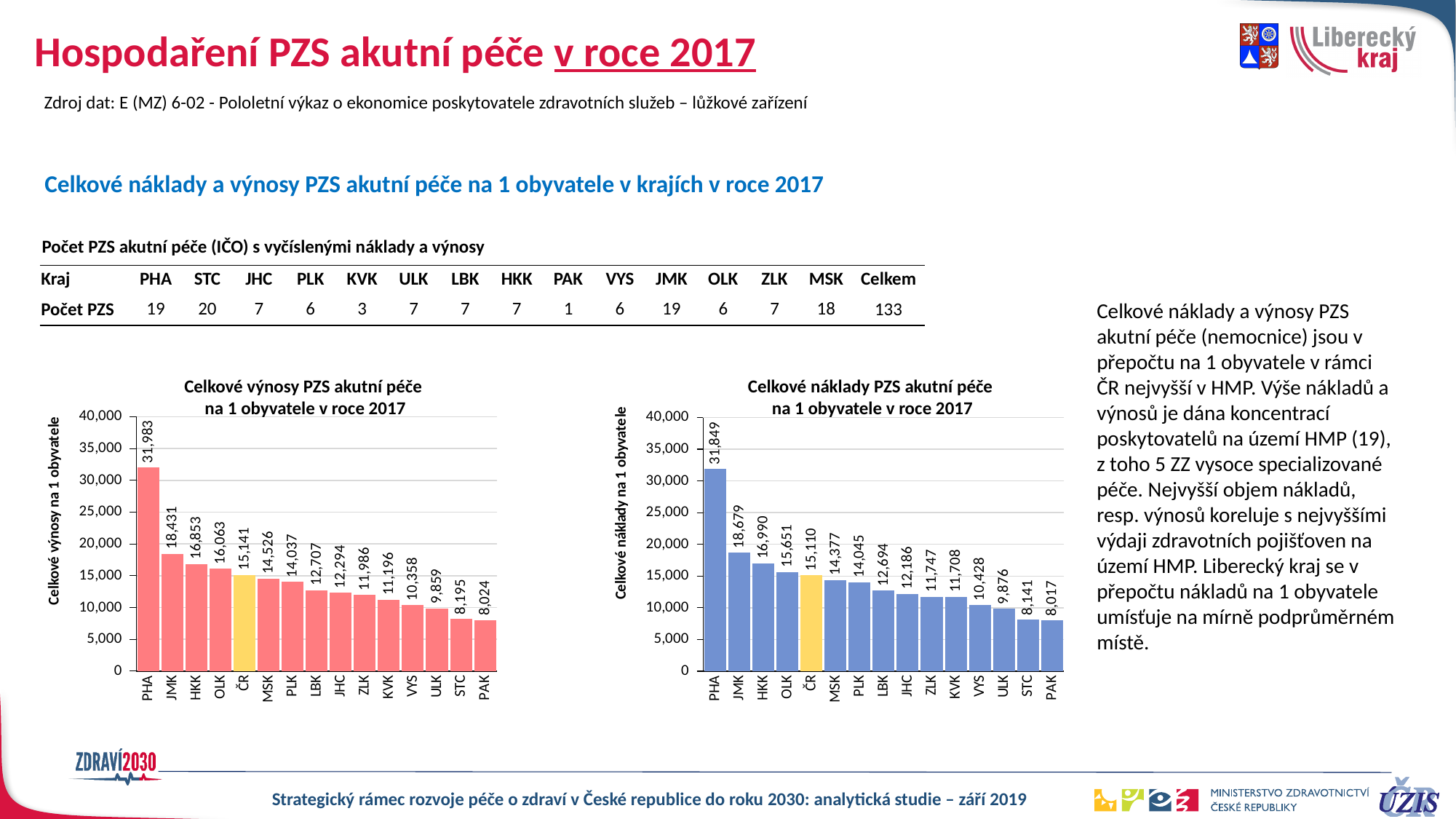
In the chart 'Celkové výnosy PZS akutní péče na 1 obyvatele v roce 2017', what is the difference between the values for PHA and JMK? 13,552 In the chart 'Celkové náklady PZS akutní péče na 1 obyvatele v roce 2017', which is larger, the value for OLK or the value for MSK? OLK In the chart 'Celkové výnosy PZS akutní péče na 1 obyvatele v roce 2017', what is the value for LBK? 12,707 In the chart 'Celkové výnosy PZS akutní péče na 1 obyvatele v roce 2017', which bar is coloured differently (yellow) from the others? ČR What kind of chart is 'Celkové výnosy PZS akutní péče na 1 obyvatele v roce 2017'? bar chart In the chart 'Celkové náklady PZS akutní péče na 1 obyvatele v roce 2017', what is the value for ČR? 15,110 In the chart 'Celkové náklady PZS akutní péče na 1 obyvatele v roce 2017', do the values rise or fall from left to right along the x axis? fall In the chart 'Celkové náklady PZS akutní péče na 1 obyvatele v roce 2017', which category has the lowest value? PAK In the chart 'Celkové výnosy PZS akutní péče na 1 obyvatele v roce 2017', which category has the highest value? PHA In the chart 'Celkové náklady PZS akutní péče na 1 obyvatele v roce 2017', what is the value for LBK? 12,694 How many categories are shown on the x axis of the chart 'Celkové náklady PZS akutní péče na 1 obyvatele v roce 2017'? 15 In the chart 'Celkové výnosy PZS akutní péče na 1 obyvatele v roce 2017', is the value for KVK greater or less than 10,000? greater